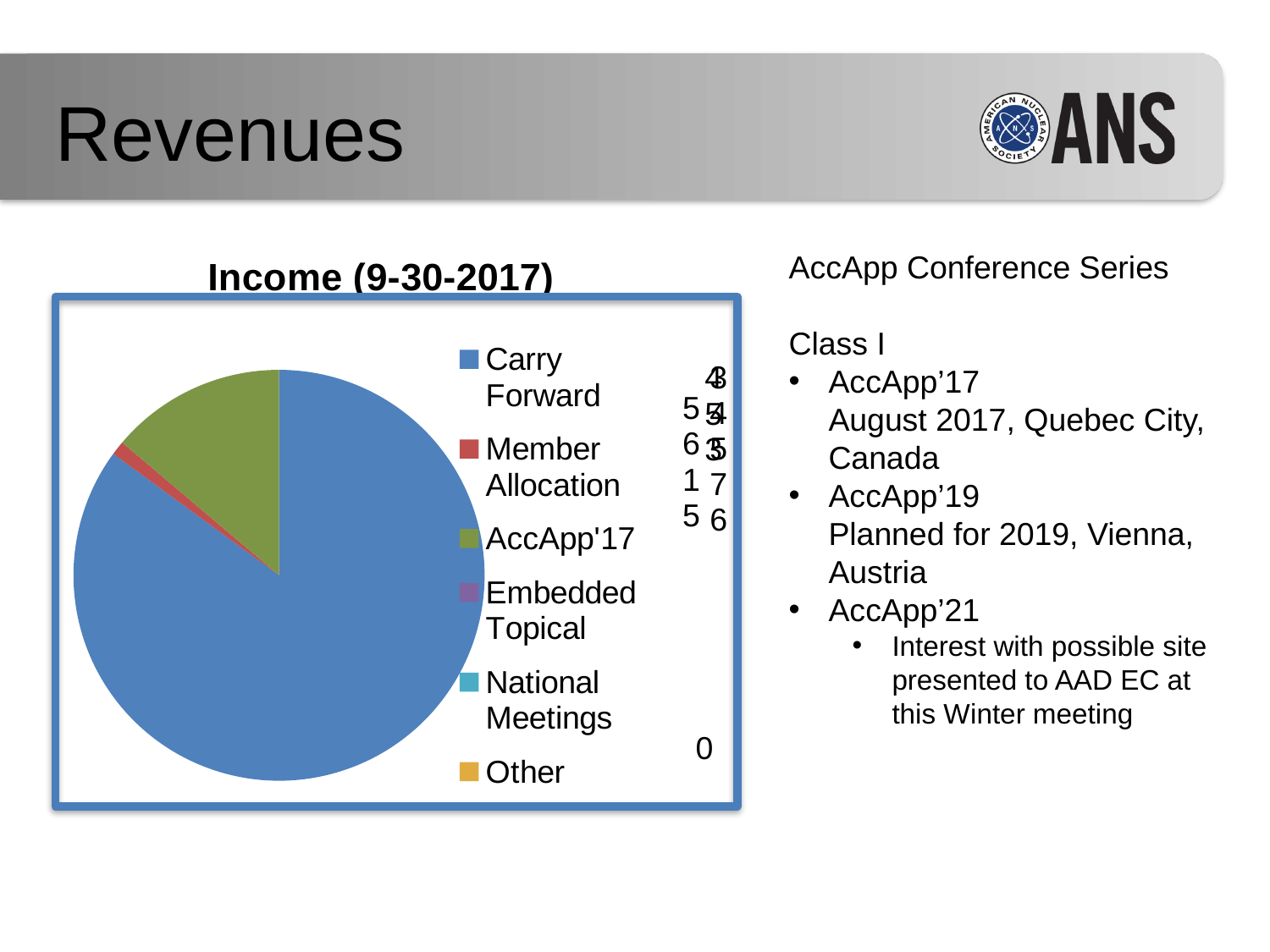
Which slice is larger, AccApp'17 or Member Allocation? AccApp'17 Which category has the largest slice of the pie? Carry Forward What kind of chart is shown on the slide? pie chart How many categories does the legend of the pie chart list? 6 Which category is the second-largest slice of the pie? AccApp'17 Which category is shown in green in the pie chart? AccApp'17 Which slice is larger, Carry Forward or AccApp'17? Carry Forward What is the title of the chart? Income (9-30-2017)